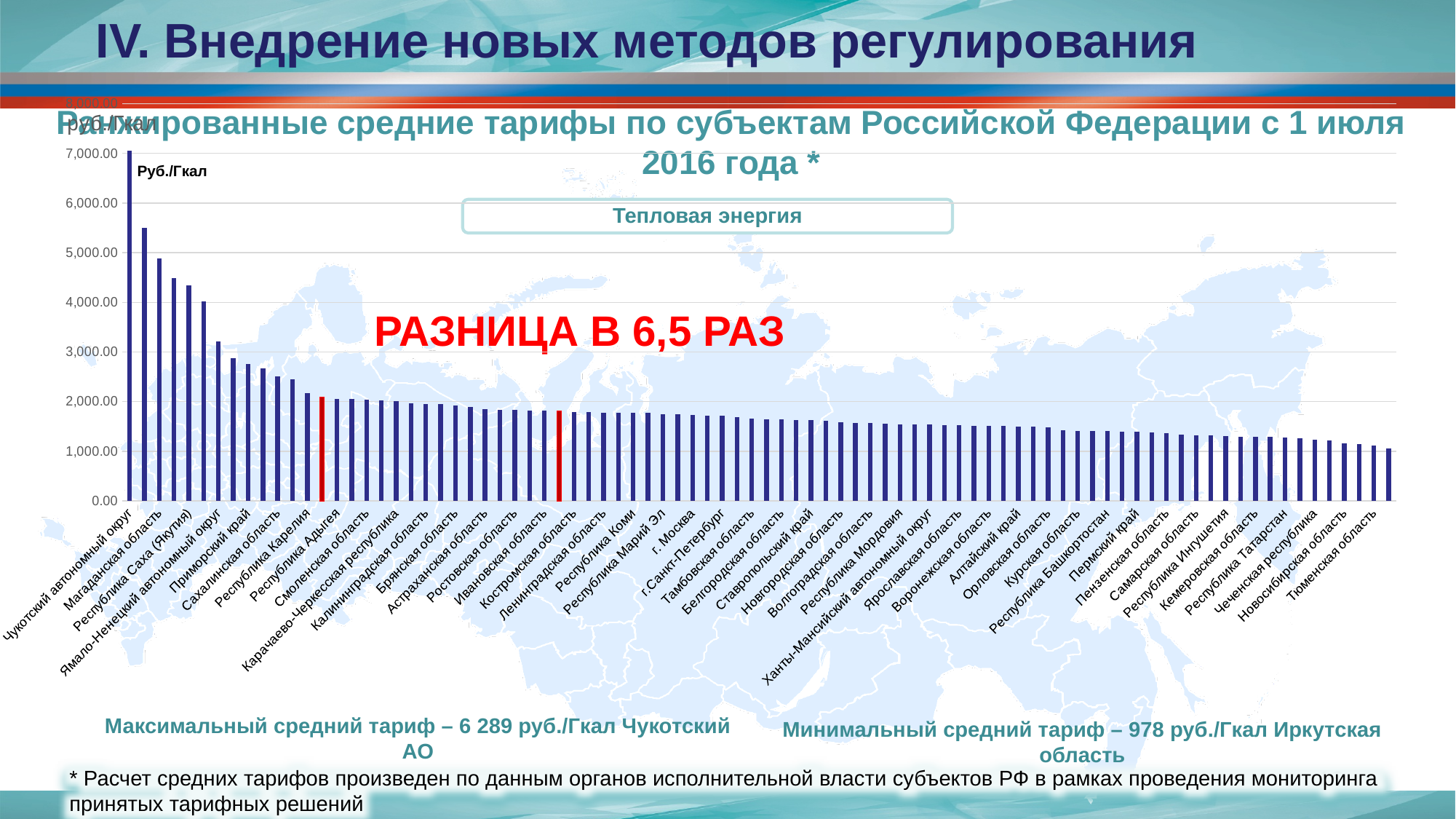
Is the value for г. Москва greater or less than 2,000.00? less Is the value for Чукотский автономный округ greater or less than 6,000.00? greater Is the value for Приморский край greater or less than 2,000.00? greater Do the bar values rise or fall from left to right along the x axis? fall What type of energy does the label box above the chart say the tariffs are for? Тепловая энергия What unit is shown on the vertical axis of the chart? Руб./Гкал What kind of chart is shown on the slide? bar chart Which has the larger value, Чукотский автономный округ or Тюменская область? Чукотский автономный округ Which region has the highest average tariff in the chart? Чукотский автономный округ